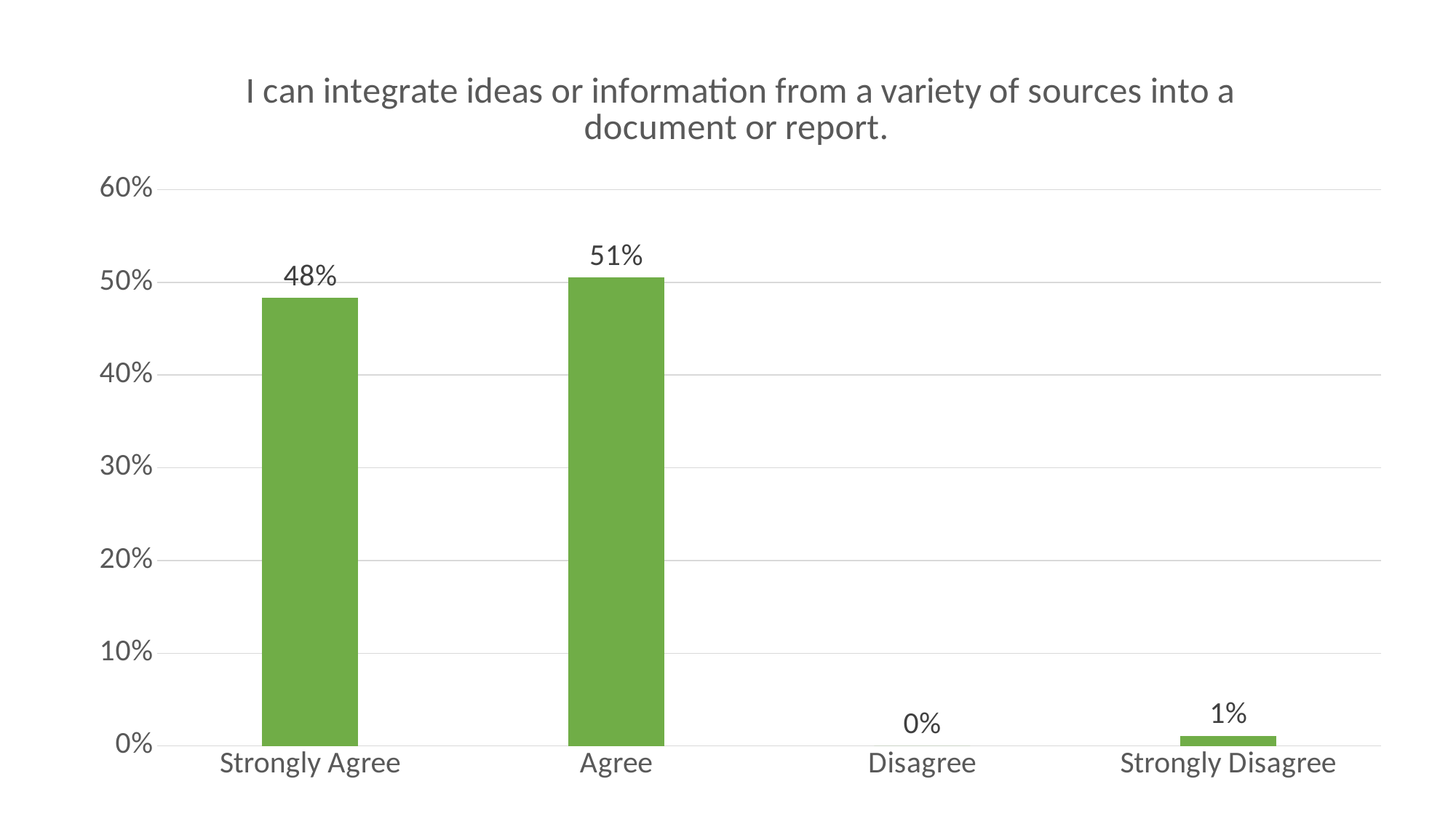
How many response categories are shown on the x axis? 4 What is the difference in percentage points between Agree and Strongly Agree? 3% What percentage of respondents chose Disagree? 0% Which response category has the lowest percentage? Disagree What is the title of the chart? I can integrate ideas or information from a variety of sources into a document or report. Is the value for Agree greater or less than 50%? greater Which is larger, the value for Strongly Agree or the value for Strongly Disagree? Strongly Agree What percentage of respondents chose Strongly Agree? 48% Which response category has the highest percentage? Agree What kind of chart is shown on the slide? Bar chart What percentage of respondents chose Strongly Disagree? 1% What percentage of respondents chose Agree? 51%